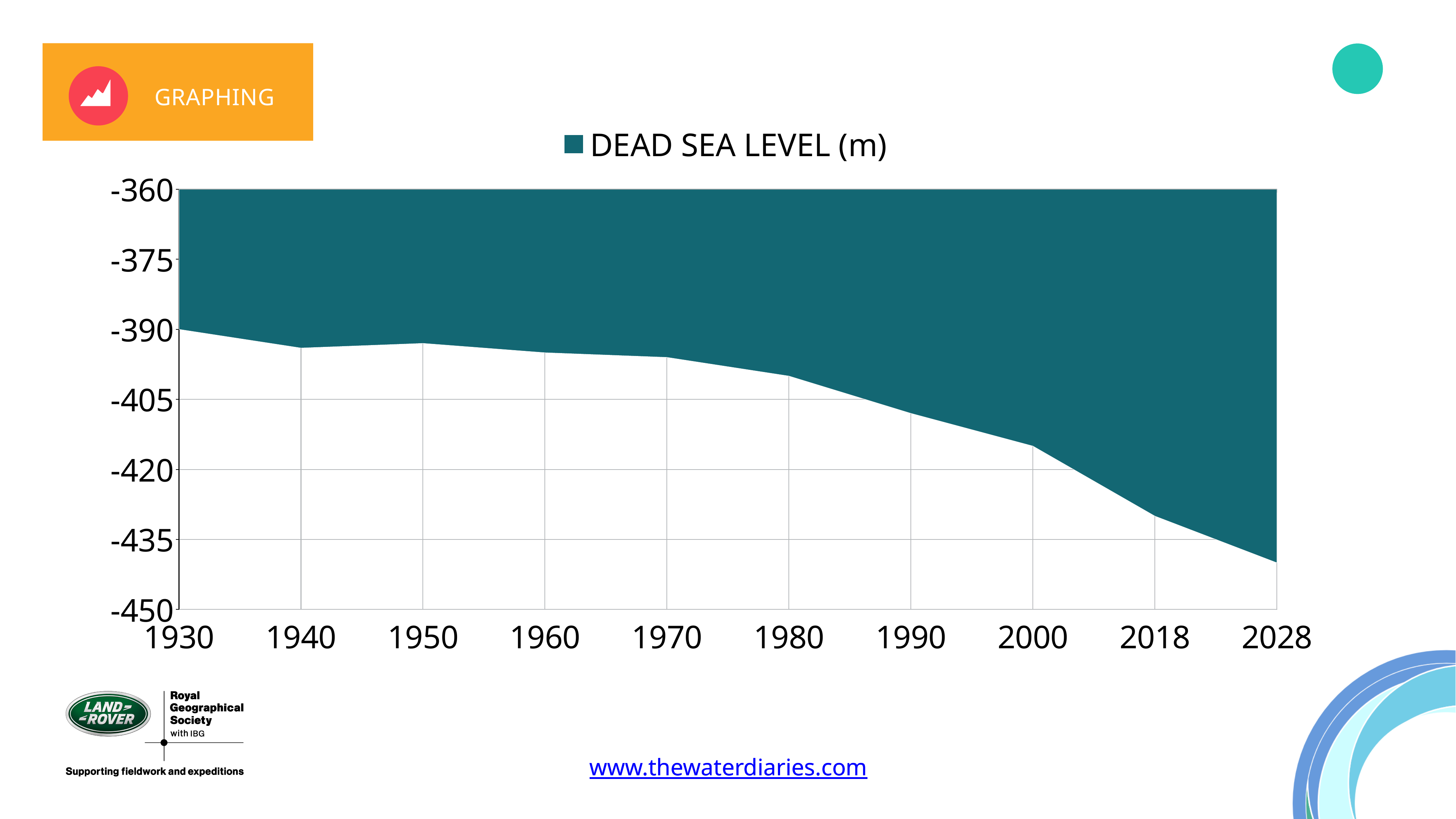
Is the Dead Sea level for 1980 greater or less than -405? greater Is the Dead Sea level for 2028 greater or less than -435? less Do the Dead Sea level values rise or fall from 1930 to 2028? fall What kind of chart is shown on the slide? area chart Is the Dead Sea level for 2000 greater or less than -420? greater Which year has the lowest (most negative) Dead Sea level? 2028 How many series does the legend list? 1 What is the name of the series shown in the legend? DEAD SEA LEVEL (m) Which year has the highest (least negative) Dead Sea level? 1930 How many years are labelled along the x axis? 10 Which year has the higher Dead Sea level, 1950 or 2018? 1950